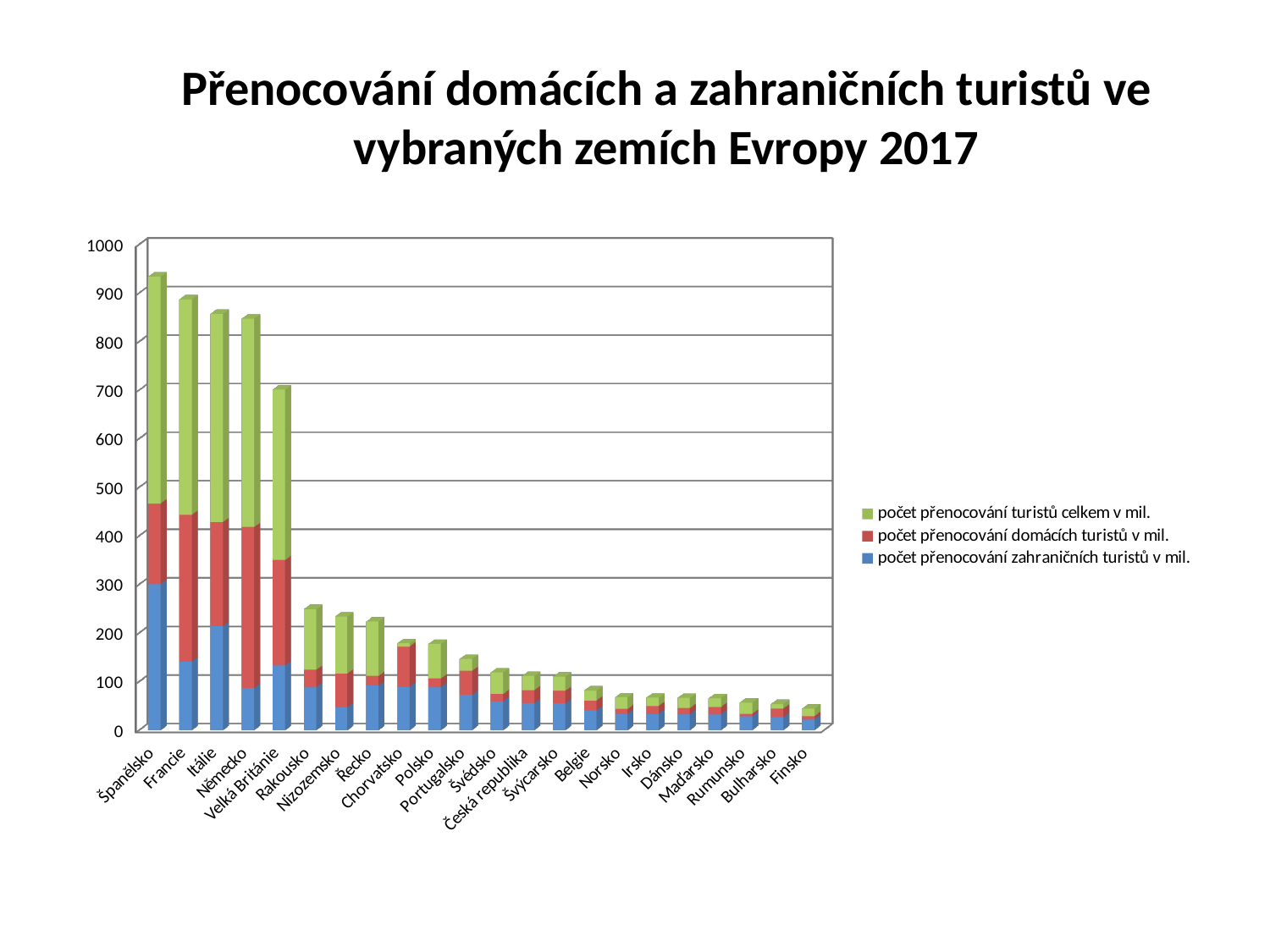
Do the stacked bar heights rise or fall moving from left to right along the x axis? fall Which country has the tallest stacked bar? Španělsko Is the blue segment (počet přenocování zahraničních turistů v mil.) for Itálie greater or less than 200? greater Which has the taller stacked bar, Španělsko or Francie? Španělsko Is the top of the stacked bar for Španělsko greater or less than 900? greater Which series is shown in green in the legend? počet přenocování turistů celkem v mil. What kind of chart is shown on the slide? stacked bar chart Is the top of the stacked bar for Francie greater or less than 900? less How many series does the legend list? 3 How many countries are shown on the x axis of the chart? 22 Which country has the shortest stacked bar? Finsko